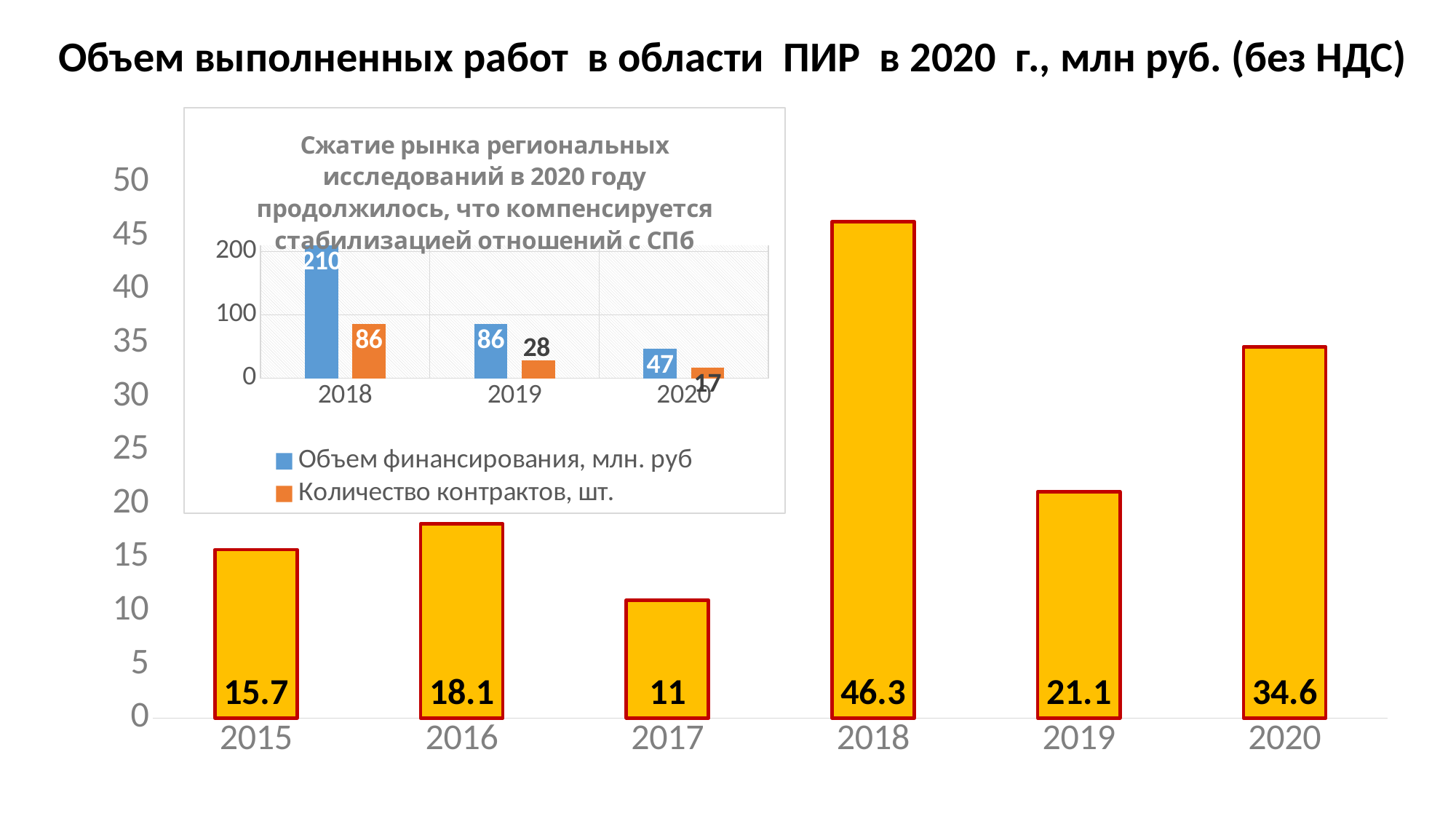
In the main chart 'Объем выполненных работ в области ПИР', what is the value for 2020? 34.6 In the main chart 'Объем выполненных работ в области ПИР', which year has the highest value? 2018 In the inset chart 'Сжатие рынка региональных исследований', what is the value of 'Количество контрактов, шт.' for 2020? 17 In the main chart 'Объем выполненных работ в области ПИР', what is the difference between the values for 2020 and 2019? 13.5 In the inset chart 'Сжатие рынка региональных исследований', what is the value of 'Объем финансирования, млн. руб' for 2019? 86 In the main chart 'Объем выполненных работ в области ПИР', which year has the lowest value? 2017 What kind of chart is the main chart 'Объем выполненных работ в области ПИР'? bar chart How many years are shown on the x axis of the main chart 'Объем выполненных работ в области ПИР'? 6 In the main chart 'Объем выполненных работ в области ПИР', what is the value for 2018? 46.3 In the inset chart 'Сжатие рынка региональных исследований', does 'Объем финансирования, млн. руб' rise or fall from 2018 to 2020? fall In the main chart 'Объем выполненных работ в области ПИР', which is larger, the value for 2015 or the value for 2016? 2016 How many series does the legend of the inset chart 'Сжатие рынка региональных исследований' list? 2